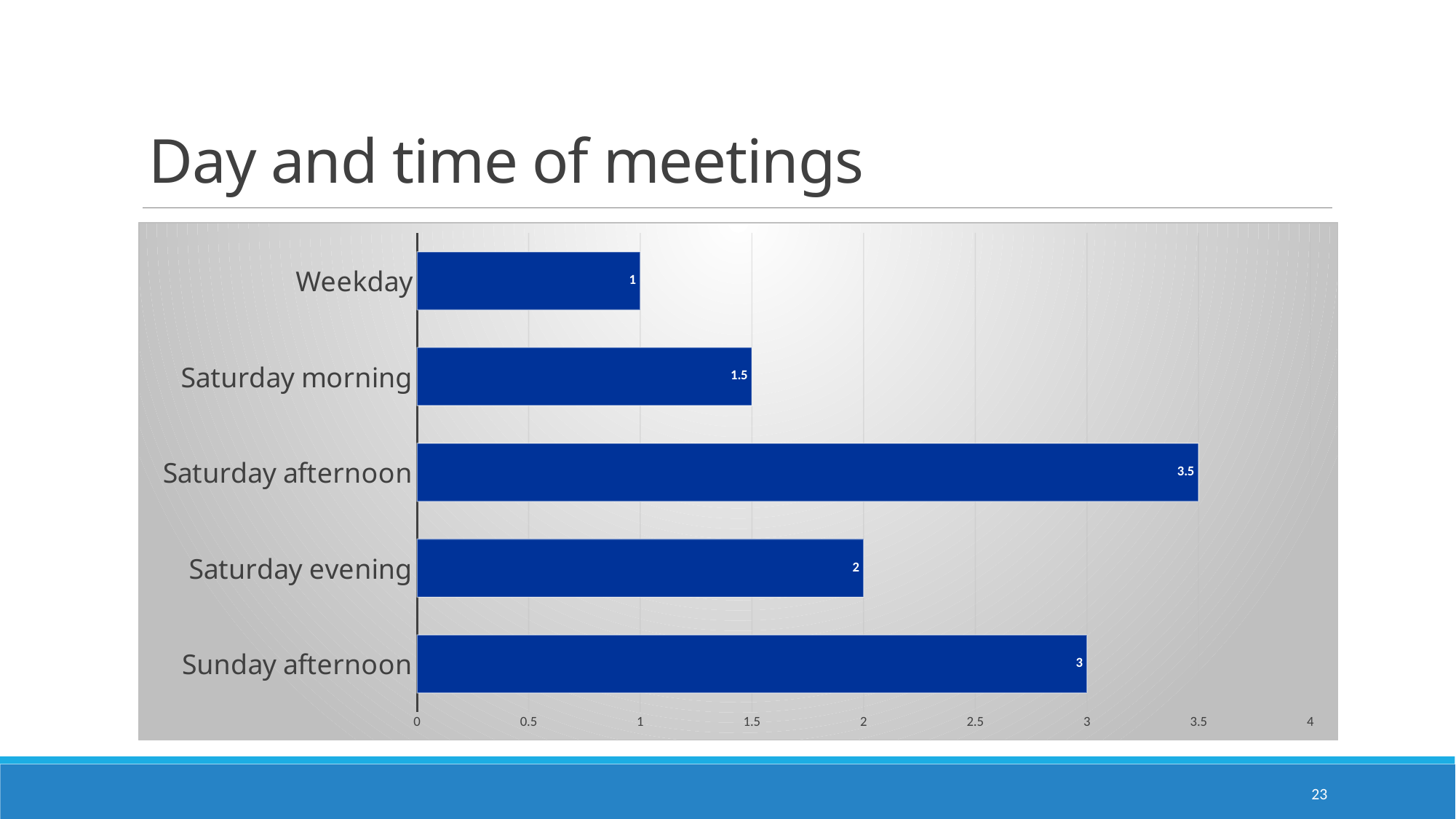
Which category has the lowest value? Weekday What is the difference between the values for Saturday afternoon and Saturday evening? 1.5 What is the value for Sunday afternoon? 3 What is the value for Saturday morning? 1.5 How many categories are shown in the chart? 5 Which category has the highest value? Saturday afternoon Which is larger, the value for Sunday afternoon or the value for Saturday evening? Sunday afternoon What kind of chart is shown on the slide? bar chart Is the value for Saturday evening greater or less than 1.5? greater What is the value for Saturday afternoon? 3.5 What is the title of the slide containing the chart? Day and time of meetings What is the value for Weekday? 1